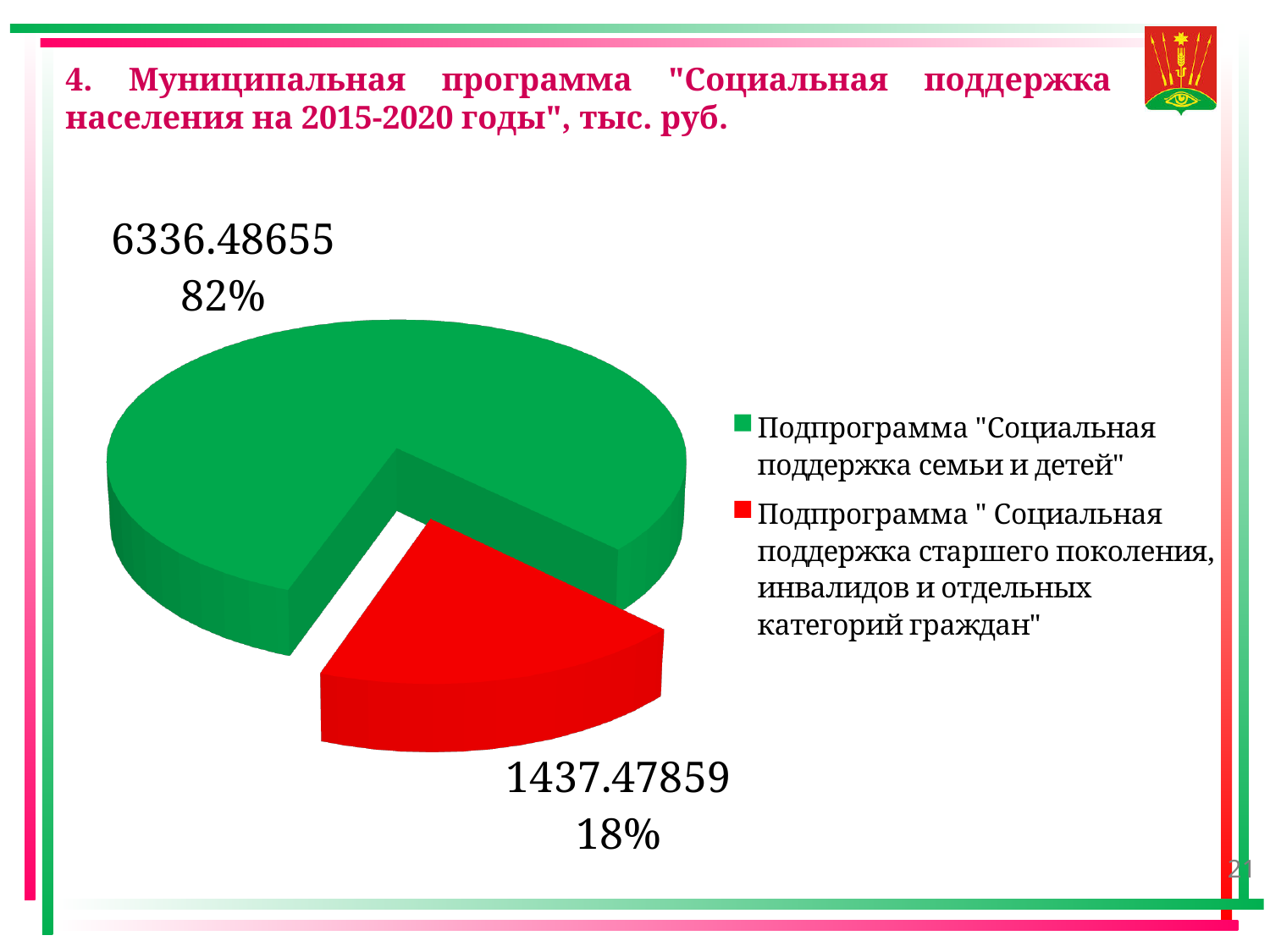
Which subprogram has the largest slice of the pie? Подпрограмма "Социальная поддержка семьи и детей" How many entries does the legend list? 2 What colour is the slice for the subprogram "Социальная поддержка семьи и детей"? green How many slices does the pie chart have? 2 What is the value for the subprogram "Социальная поддержка семьи и детей"? 6336.48655 Which is larger: the value for "Социальная поддержка семьи и детей" or for "Социальная поддержка старшего поколения, инвалидов и отдельных категорий граждан"? Социальная поддержка семьи и детей What kind of chart is shown on the slide? pie chart What is the value for the subprogram "Социальная поддержка старшего поколения, инвалидов и отдельных категорий граждан"? 1437.47859 What is the difference between the values of the two subprograms? 4899.00796 Which subprogram has the smallest slice of the pie? Подпрограмма "Социальная поддержка старшего поколения, инвалидов и отдельных категорий граждан" What share of the pie does the subprogram "Социальная поддержка старшего поколения, инвалидов и отдельных категорий граждан" take? 18% What share of the pie does the subprogram "Социальная поддержка семьи и детей" take? 82%